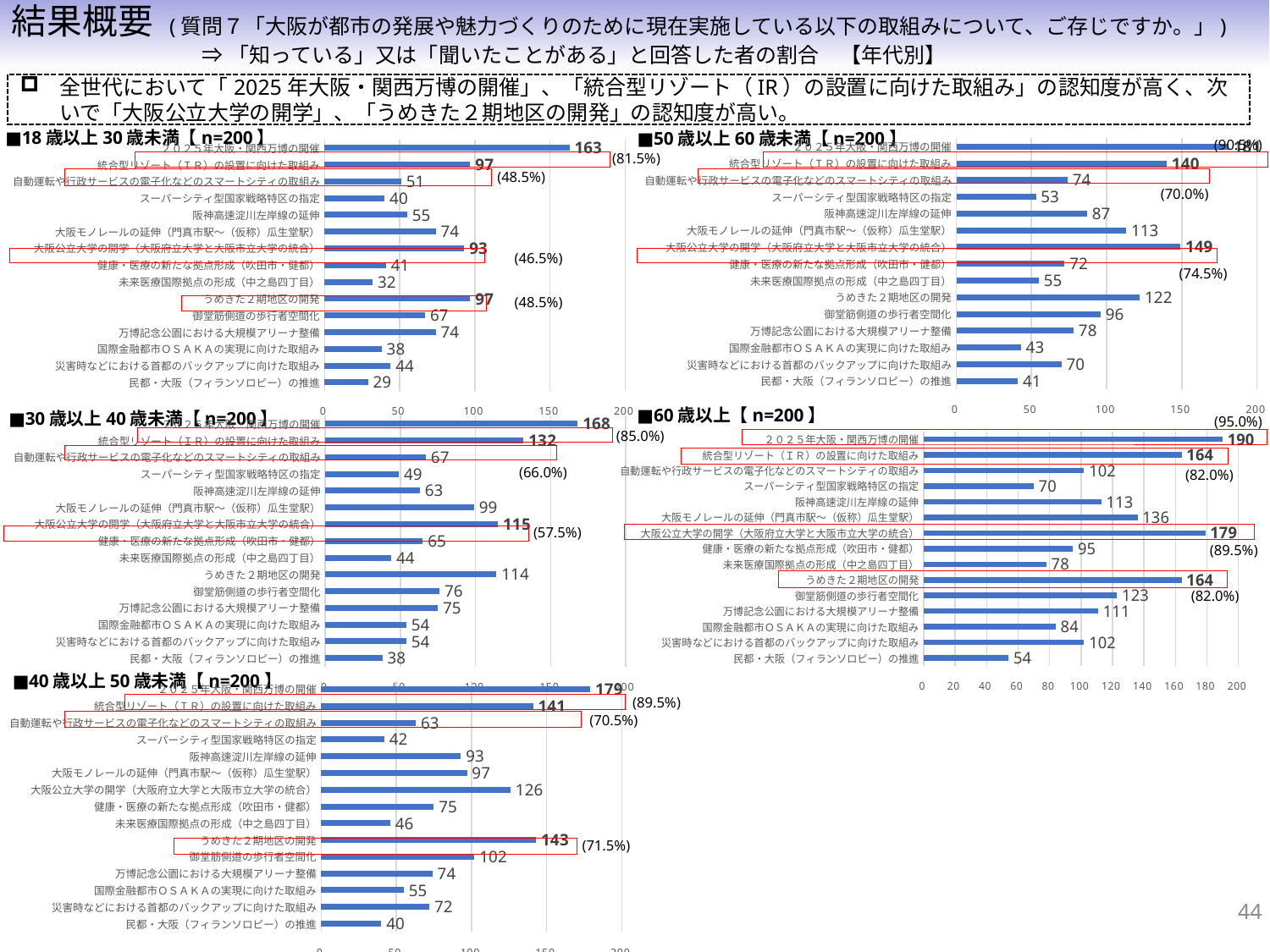
In the 30歳以上40歳未満 chart, what is the difference between 2025年大阪・関西万博の開催 and 統合型リゾート（ＩＲ）の設置に向けた取組み? 36 In the 60歳以上 chart, what is the value for 2025年大阪・関西万博の開催? 190 How many categories are plotted in the 60歳以上 chart? 15 In the 50歳以上60歳未満 chart, what is the value for 大阪公立大学の開学（大阪府立大学と大阪市立大学の統合）? 149 In the 60歳以上 chart, what is the difference between 大阪公立大学の開学 and うめきた２期地区の開発? 15 In the 40歳以上50歳未満 chart, which is larger, 阪神高速淀川左岸線の延伸 or 大阪モノレールの延伸（門真市駅～（仮称）瓜生堂駅）? 大阪モノレールの延伸（門真市駅～（仮称）瓜生堂駅） In the 18歳以上30歳未満 chart, which category has the lowest value? 民都・大阪（フィランソロピー）の推進 What type of chart is used for the 18歳以上30歳未満 age group? Bar chart In the 30歳以上40歳未満 chart, what is the value for 大阪公立大学の開学（大阪府立大学と大阪市立大学の統合）? 115 In the 18歳以上30歳未満 chart, what is the value for 2025年大阪・関西万博の開催? 163 In the 40歳以上50歳未満 chart, what is the value for うめきた２期地区の開発? 143 In the 50歳以上60歳未満 chart, which category has the highest value? ２０２５年大阪・関西万博の開催